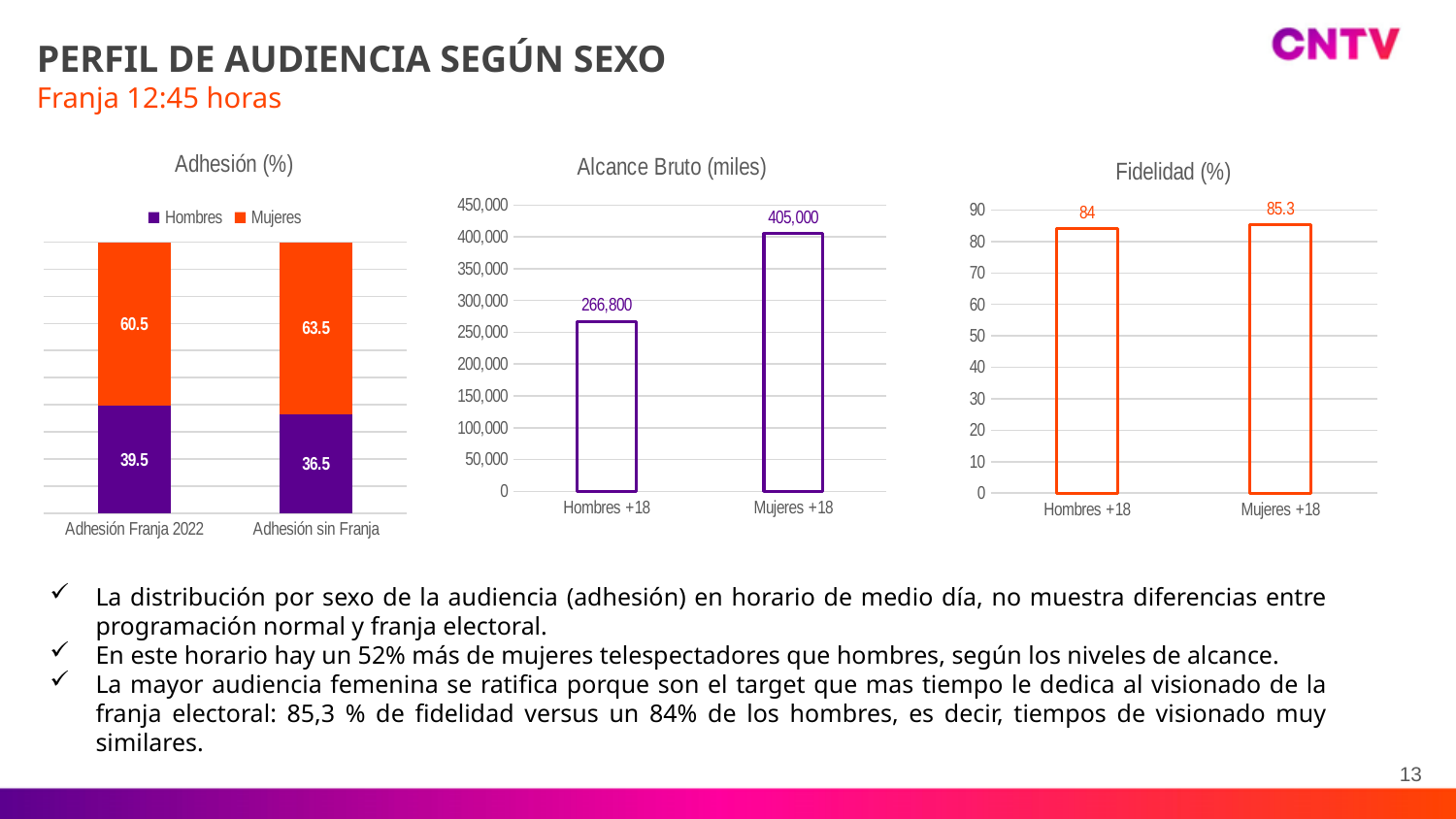
In the 'Alcance Bruto (miles)' chart, is the value for Hombres +18 greater or less than 300,000? less In the 'Adhesión (%)' chart, what is the total of the Adhesión Franja 2022 bar? 100 In the 'Adhesión (%)' chart, what is the difference between the Mujeres values for Adhesión sin Franja and Adhesión Franja 2022? 3 In the 'Alcance Bruto (miles)' chart, what is the difference between Mujeres +18 and Hombres +18? 138,200 In the 'Alcance Bruto (miles)' chart, what is the value for Hombres +18? 266,800 In the 'Adhesión (%)' chart, what is the value for Hombres in Adhesión sin Franja? 36.5 In the 'Adhesión (%)' chart, what is the value for Mujeres in Adhesión Franja 2022? 60.5 In the 'Alcance Bruto (miles)' chart, which category has the highest value? Mujeres +18 In the 'Fidelidad (%)' chart, how many categories are shown? 2 In the 'Fidelidad (%)' chart, what is the value for Mujeres +18? 85.3 In the 'Adhesión (%)' chart, how many series does the legend list? 2 What kind of chart is the 'Fidelidad (%)' chart? Bar chart